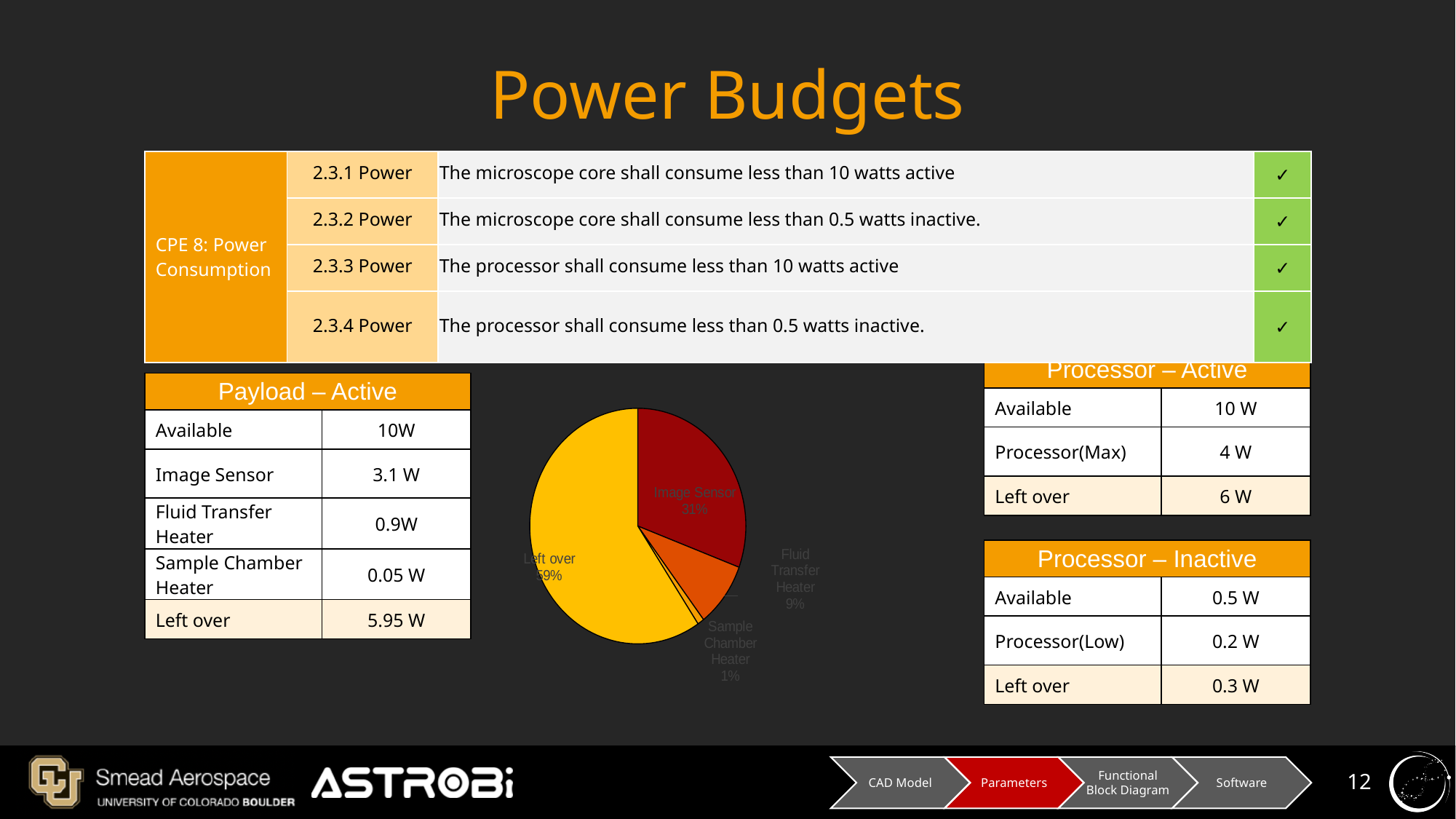
What colour is the Left over slice in the pie chart? yellow Which slice of the pie chart is the smallest? Sample Chamber Heater In the pie chart, what is the difference in percentage points between Image Sensor and Fluid Transfer Heater? 22 What share of the pie chart does Sample Chamber Heater take? 1% What share of the pie chart does Left over take? 59% In the pie chart, which is larger: Image Sensor or Fluid Transfer Heater? Image Sensor What kind of chart is shown on the slide? pie chart How many slices does the pie chart have? 4 Which slice of the pie chart is the largest? Left over In the pie chart, what is the difference in percentage points between Left over and Image Sensor? 28 What share of the pie chart does Fluid Transfer Heater take? 9%